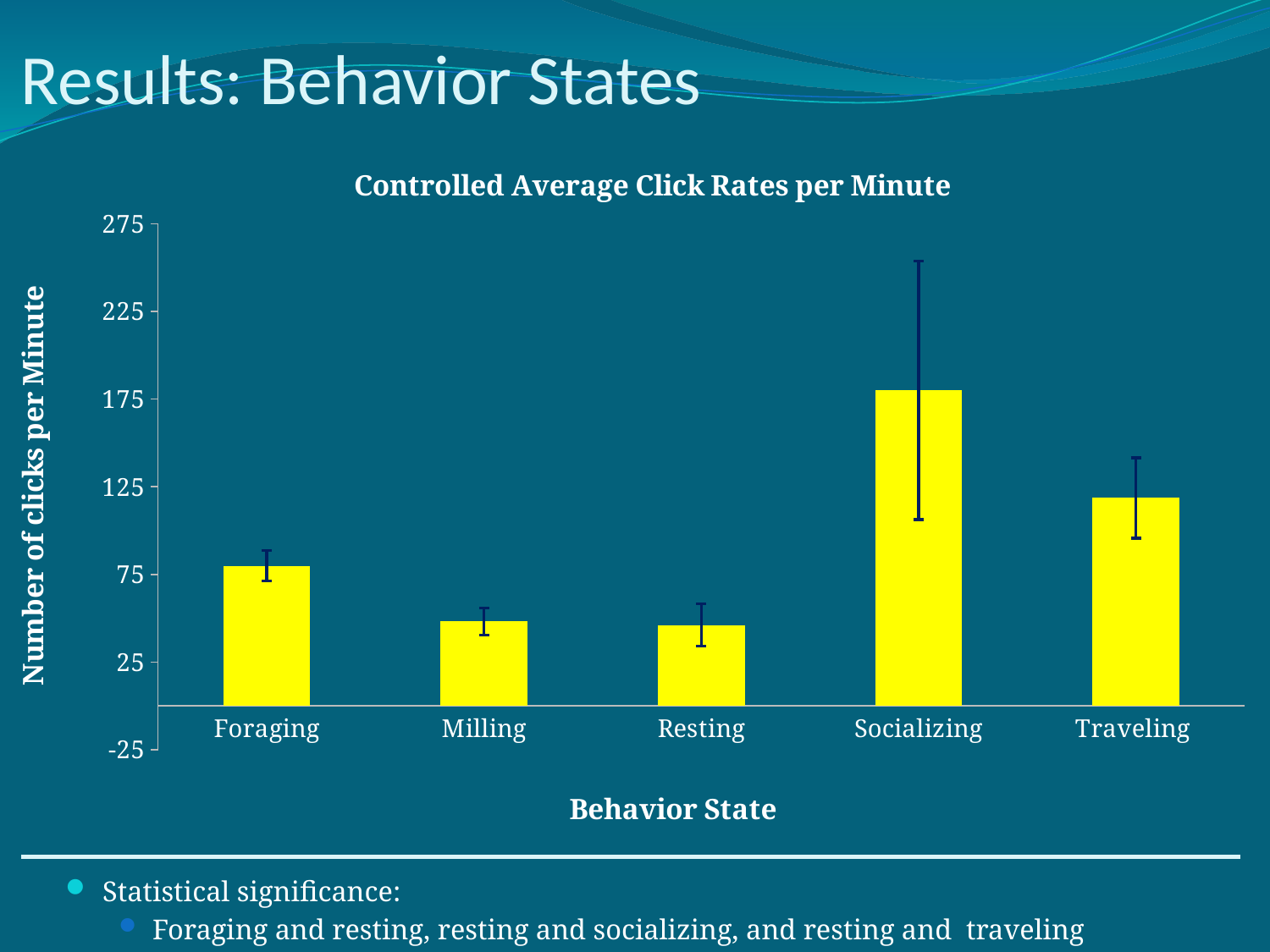
What is the title of the chart? Controlled Average Click Rates per Minute Which has a higher average click rate, Foraging or Resting? Foraging Is the value for Socializing greater or less than 125? greater Which behavior state has the highest average click rate? Socializing Is the value for Foraging greater or less than 125? less Is the value for Traveling greater or less than 75? greater What is the label of the y axis of the chart? Number of clicks per Minute Which has a higher average click rate, Traveling or Foraging? Traveling What kind of chart is shown on the slide? bar chart Which has a higher average click rate, Socializing or Traveling? Socializing How many behavior states are shown on the x axis of the chart? 5